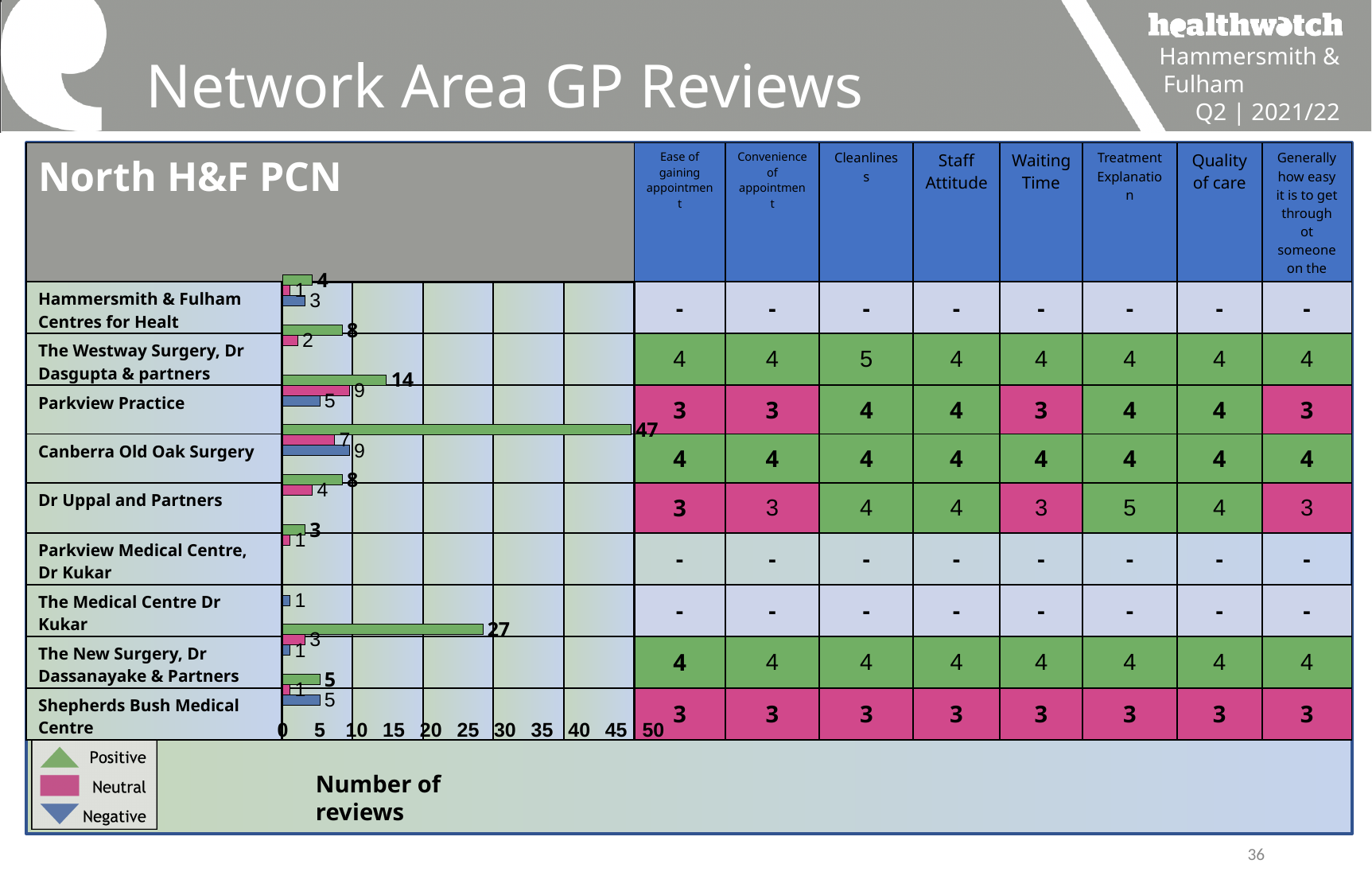
Is the number of positive reviews for Canberra Old Oak Surgery greater or less than 40? greater What is the difference between the positive reviews for Canberra Old Oak Surgery and The New Surgery, Dr Dassanayake & Partners? 20 How many practices are listed in the reviews chart? 9 How many series does the legend of the reviews chart list? 3 What is the label on the horizontal axis of the reviews chart? Number of reviews How many positive reviews does Canberra Old Oak Surgery have? 47 How many positive reviews does The New Surgery, Dr Dassanayake & Partners have? 27 Which has more positive reviews, Parkview Practice or The Westway Surgery, Dr Dasgupta & partners? Parkview Practice What kind of chart is used to show the number of reviews on the slide? bar chart Which practice has the highest number of positive reviews in the chart? Canberra Old Oak Surgery How many negative reviews does Canberra Old Oak Surgery have? 9 How many positive reviews does Parkview Practice have? 14